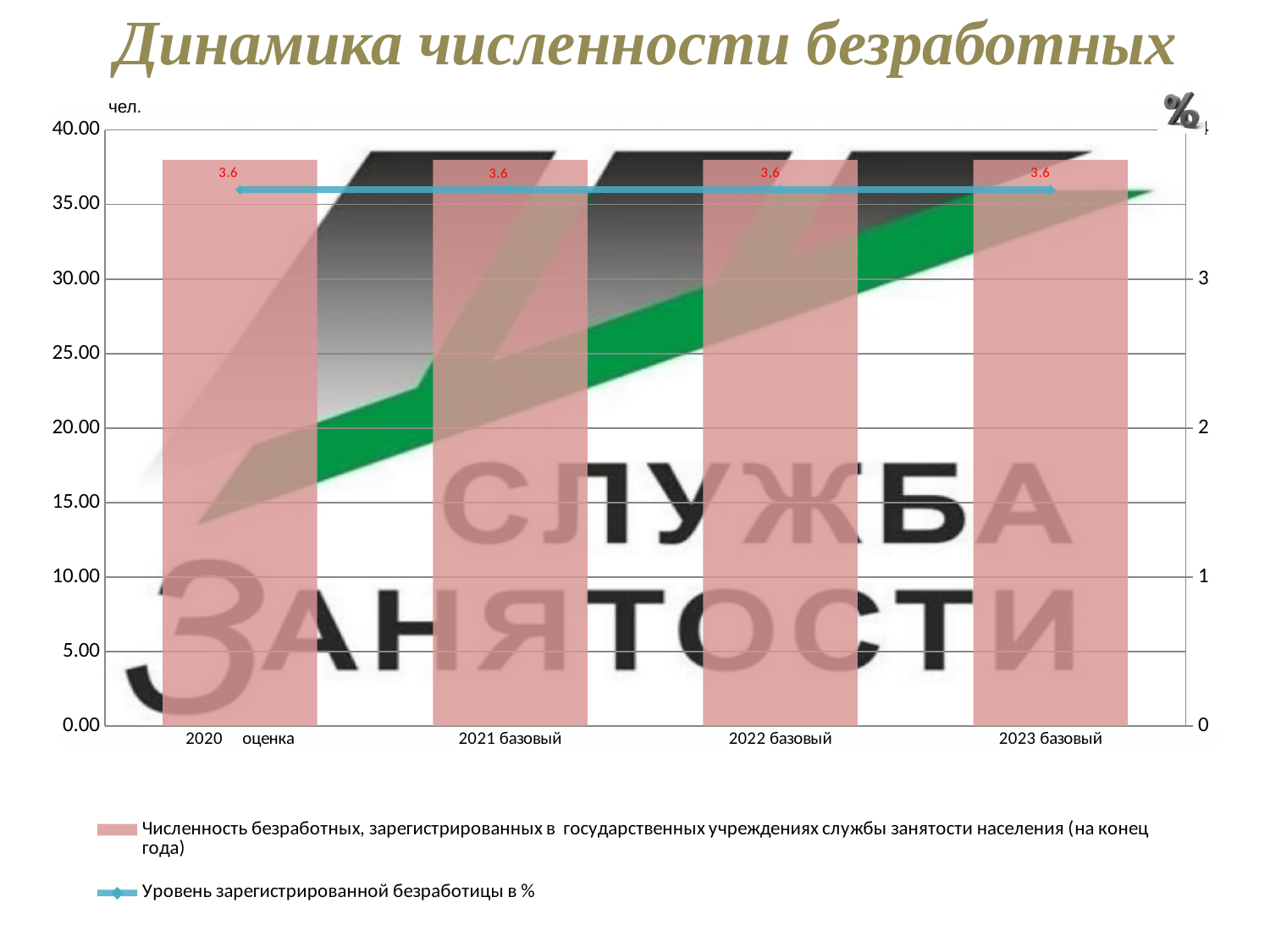
What value does the line series show for 2023 базовый? 3.6 What unit label is shown above the left vertical axis? чел. Is the bar value for 2020 оценка greater or less than 35? greater Is the bar value for 2022 базовый greater or less than 40? less What is the registered unemployment rate (Уровень зарегистрированной безработицы в %) shown for 2021 базовый? 3.6 What is the difference between the unemployment rate in 2023 базовый and in 2020 оценка? 0 How many categories (years) are shown on the x axis? 4 How many series does the legend list? 2 Does the registered unemployment rate rise, fall or stay flat from 2020 to 2023? It stays flat What is the title of the chart? Динамика численности безработных What value does the line series show for 2020 оценка? 3.6 What kind of chart is this? A combined bar and line chart